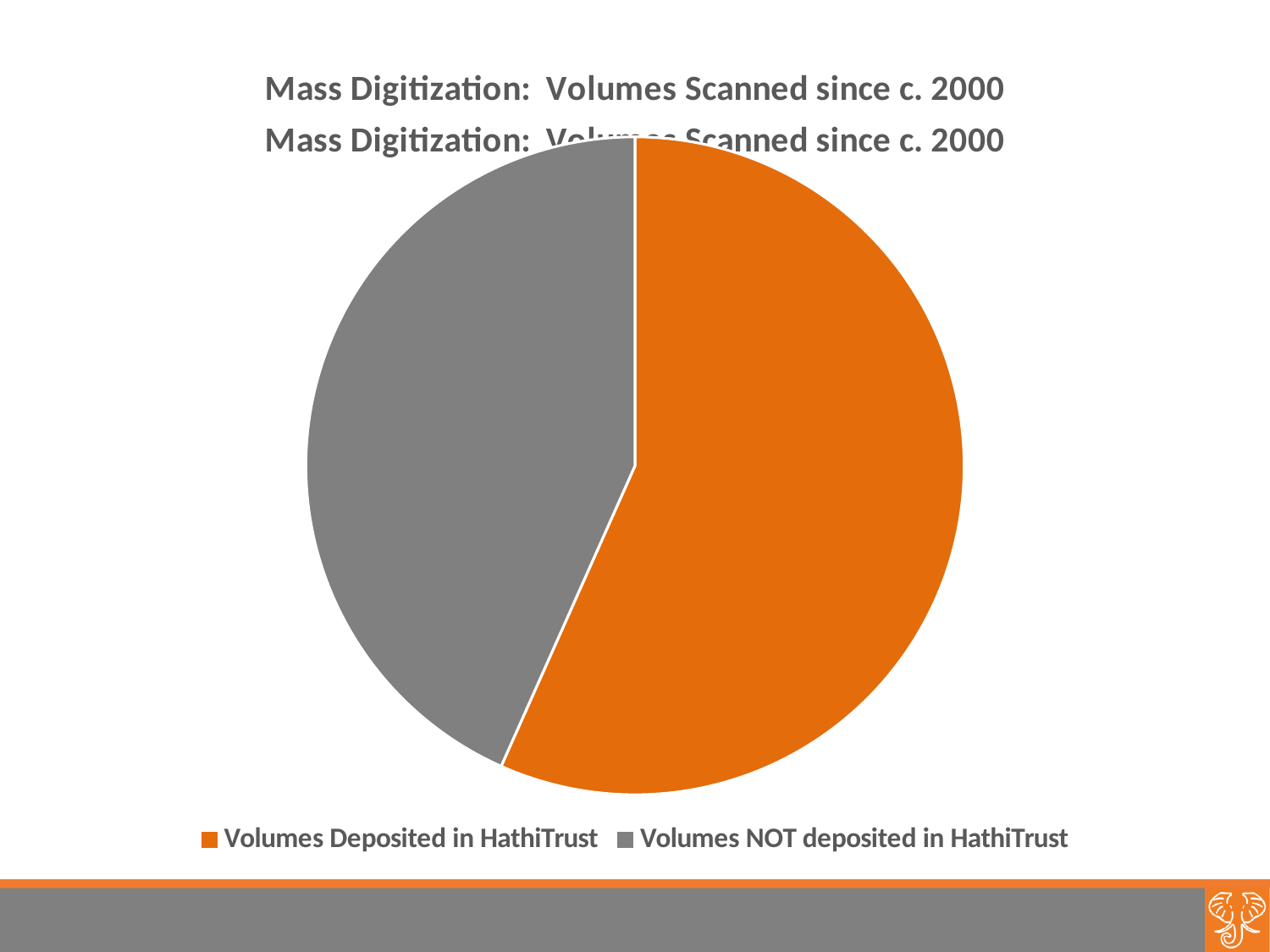
What colour is the slice for Volumes NOT deposited in HathiTrust? Gray What kind of chart is shown on the slide? Pie chart Which is larger: Volumes Deposited in HathiTrust or Volumes NOT deposited in HathiTrust? Volumes Deposited in HathiTrust Which slice of the pie chart is the largest? Volumes Deposited in HathiTrust How many slices does the pie chart have? 2 Is the slice for Volumes Deposited in HathiTrust more or less than half of the pie? more Which slice of the pie chart is the smallest? Volumes NOT deposited in HathiTrust How many entries does the legend list? 2 What is the title of the chart? Mass Digitization: Volumes Scanned since c. 2000